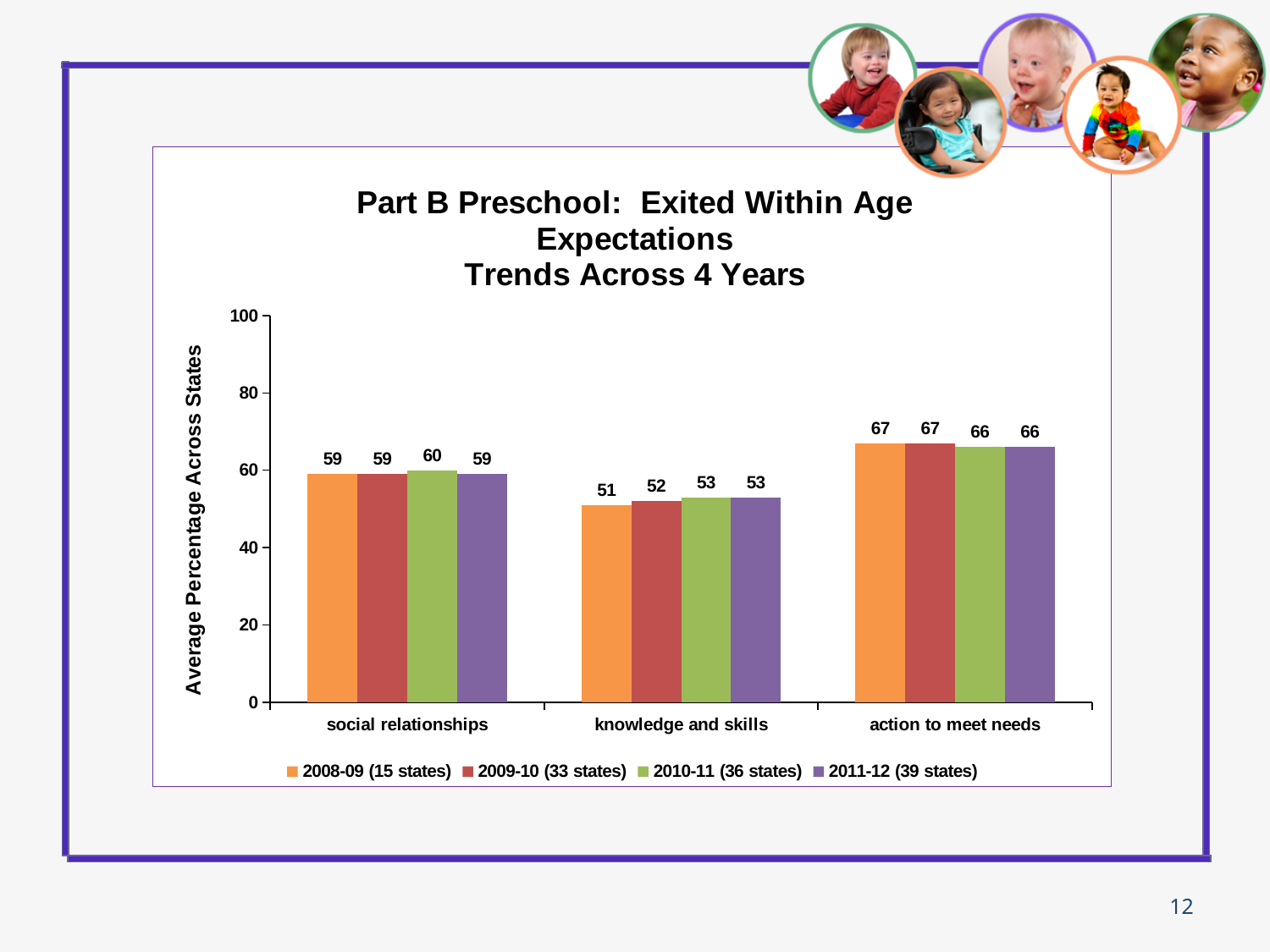
What is the label of the vertical axis? Average Percentage Across States Is the value for action to meet needs in the 2008-09 (15 states) series greater or less than 60? greater How many categories are shown on the x axis? 3 Which category has the highest value in the 2009-10 (33 states) series? action to meet needs What kind of chart is shown on the slide? bar chart Which category has the lowest value in the 2011-12 (39 states) series? knowledge and skills What is the value for knowledge and skills in the 2008-09 (15 states) series? 51 How many series does the legend list? 4 What is the value for social relationships in the 2010-11 (36 states) series? 60 What is the difference between the 2008-09 (15 states) values for action to meet needs and knowledge and skills? 16 What is the value for action to meet needs in the 2011-12 (39 states) series? 66 Which is larger: the 2010-11 (36 states) value for social relationships or for knowledge and skills? social relationships